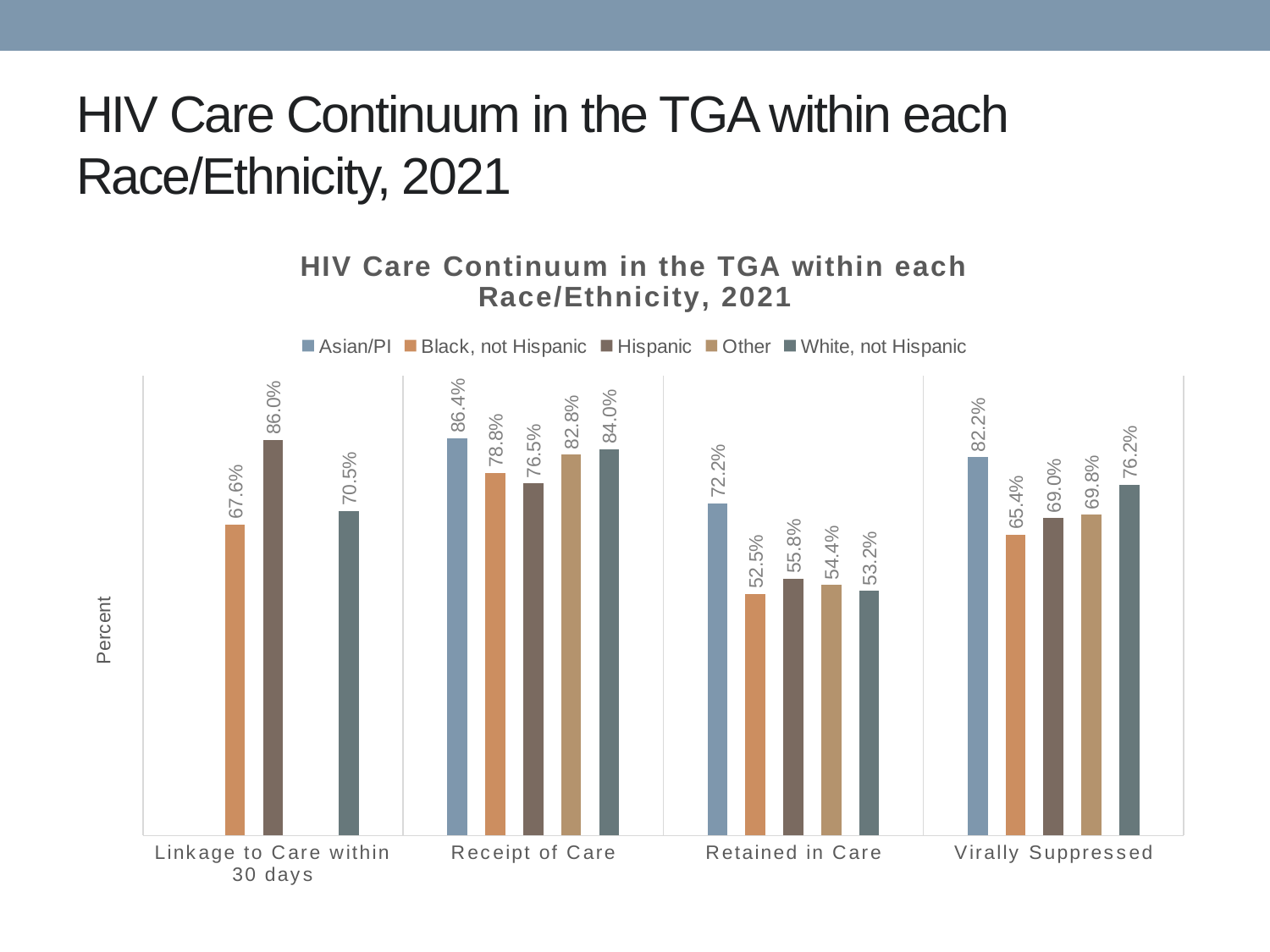
How many series does the legend list? 5 Which race/ethnicity has the lowest value in the Retained in Care category? Black, not Hispanic What is the value for White, not Hispanic in the Virally Suppressed category? 76.2% What is the label on the vertical axis of the chart? Percent Which race/ethnicity has the highest value in the Virally Suppressed category? Asian/PI What is the value for Hispanic in the Linkage to Care within 30 days category? 86.0% What is the difference between the Asian/PI and Black, not Hispanic values in the Retained in Care category? 19.7% In the Receipt of Care category, which is larger: the value for Other or the value for Hispanic? Other What kind of chart is shown on the slide? Bar chart What is the value for Asian/PI in the Receipt of Care category? 86.4% How many categories are shown on the x axis? 4 What is the value for Black, not Hispanic in the Retained in Care category? 52.5%